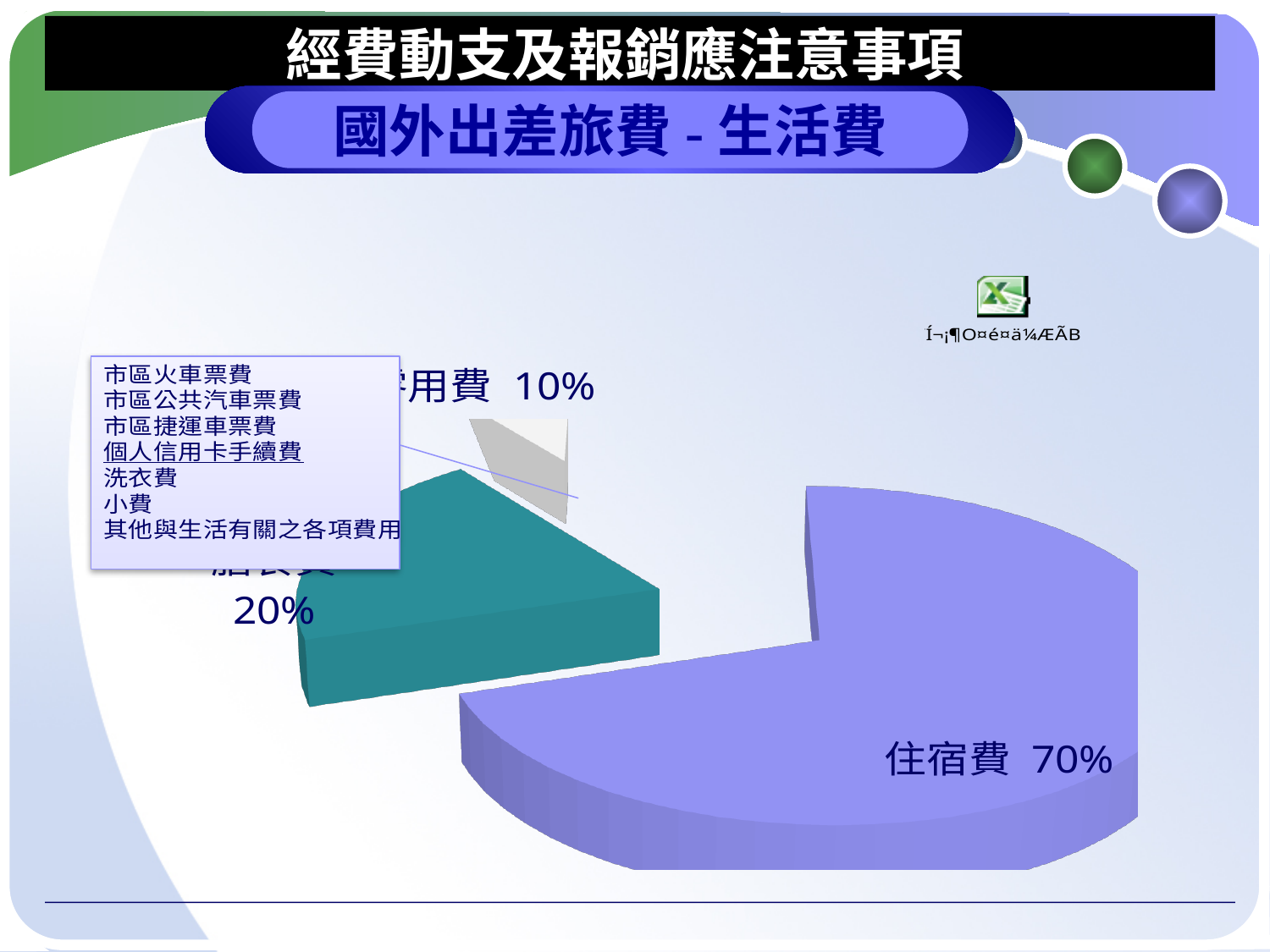
What percentage is shown for the teal (green) slice of the pie? 20% What is the difference in percentage points between the 住宿費 slice and the teal 20% slice? 50 Is the share for 住宿費 greater or less than 50%? greater What is the subtitle shown above the pie chart? 國外出差旅費 - 生活費 Which category has the largest slice of the pie? 住宿費 How many slices does the pie chart have? 3 What percentage is shown for the smallest (grey) slice of the pie? 10% What share of the pie does 住宿費 represent? 70% What type of chart is shown on the slide? pie chart What is the combined share of the teal 20% slice and the grey 10% slice? 30% Which is larger, the 住宿費 slice or the grey 10% slice? 住宿費 What colour is the 住宿費 slice of the pie? purple (blue-violet)